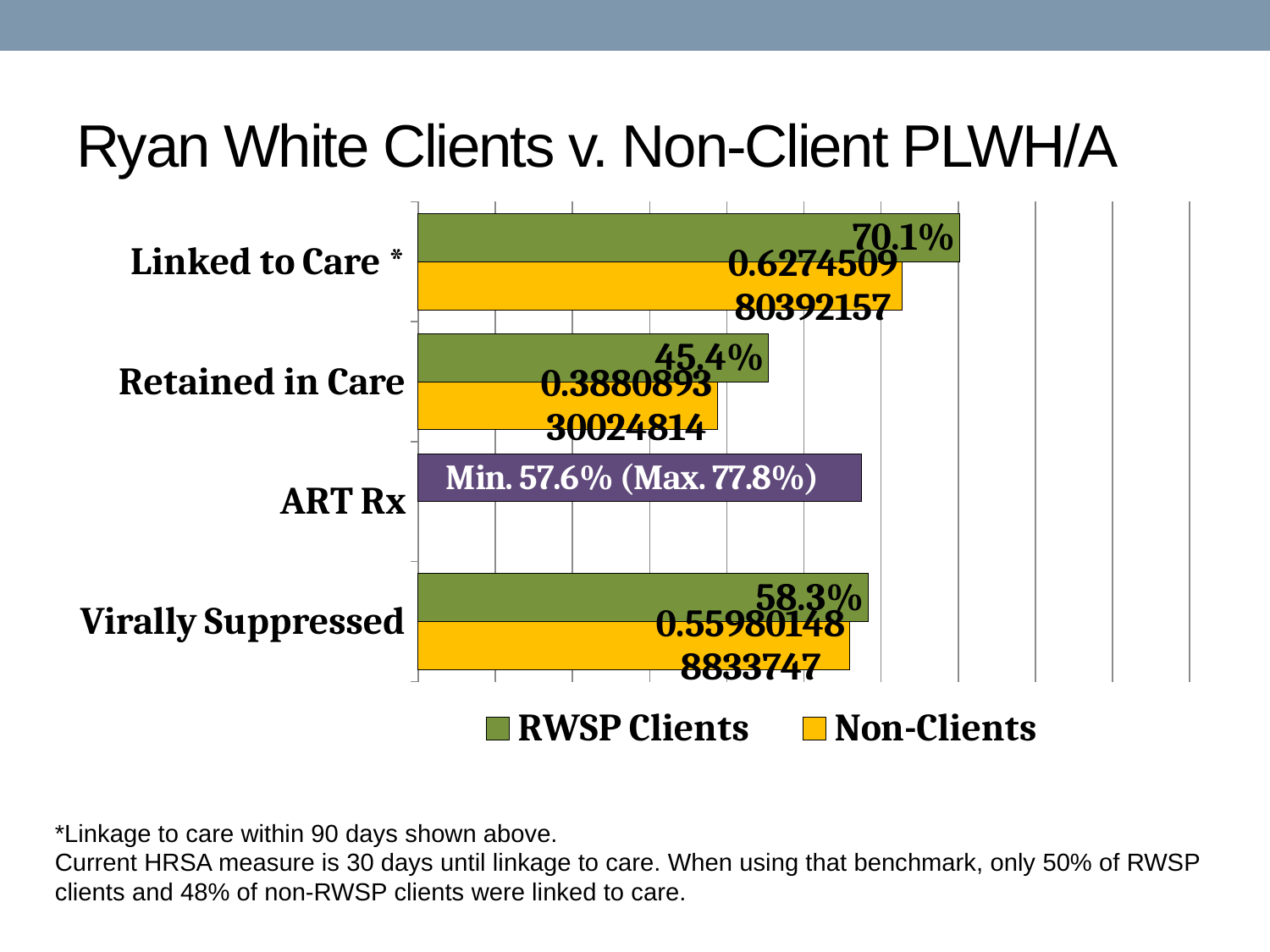
What is the difference between the RWSP Clients values for Linked to Care and Retained in Care? 24.7 percentage points What is the value for RWSP Clients in the Linked to Care category? 70.1% What type of chart is shown on the slide? Bar chart Among the RWSP Clients bars, which category has the lowest value? Retained in Care What is the value for RWSP Clients in the Retained in Care category? 45.4% How many categories are shown on the vertical axis of the chart? 4 What label is printed on the ART Rx bar? Min. 57.6% (Max. 77.8%) How many series does the legend list? 2 Among the RWSP Clients bars, which category has the highest value? Linked to Care What is the title of the chart? Ryan White Clients v. Non-Client PLWH/A What is the value for RWSP Clients in the Virally Suppressed category? 58.3% In the Retained in Care category, which series has the larger value, RWSP Clients or Non-Clients? RWSP Clients